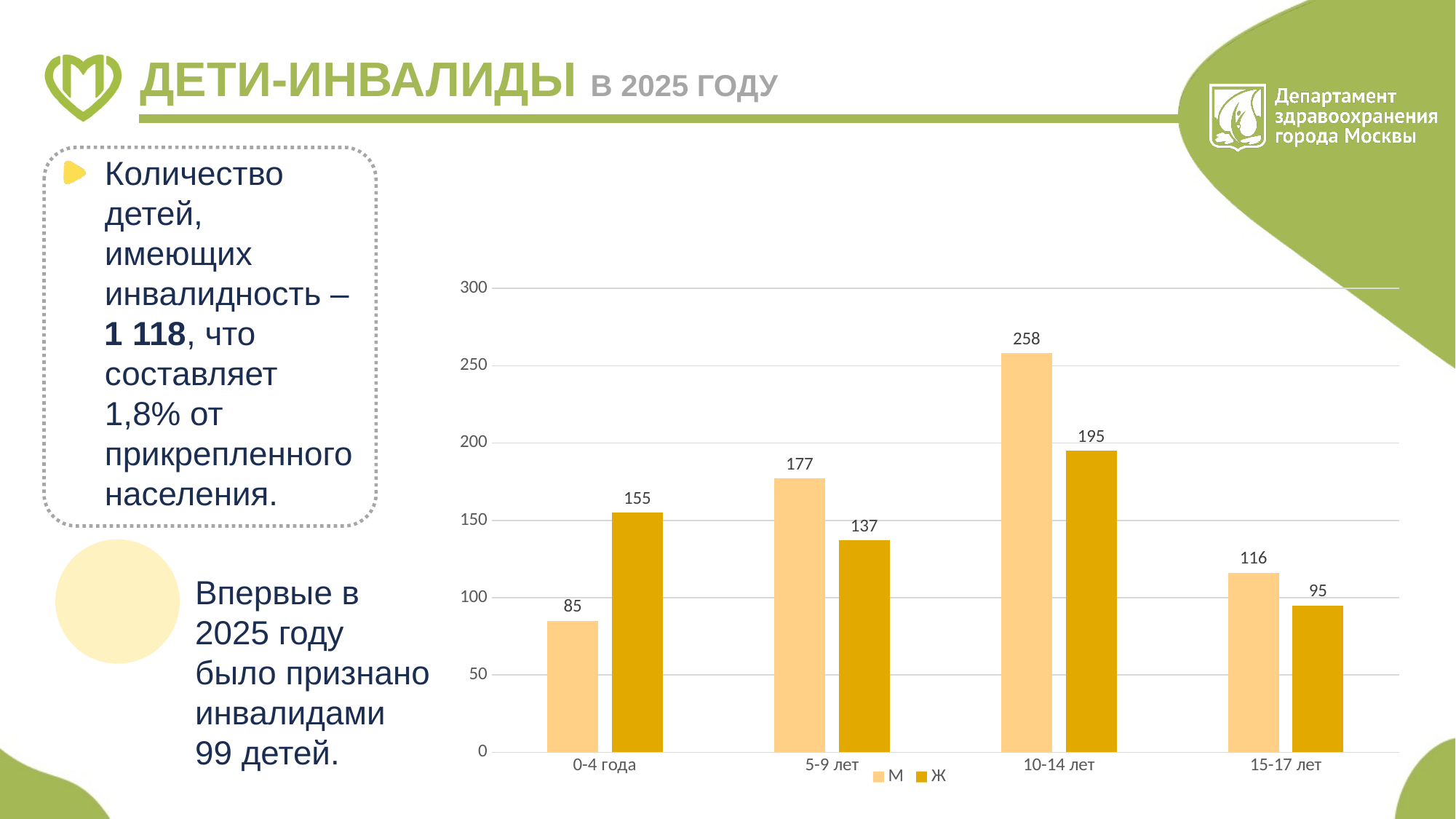
How many series does the legend list? 2 What is the difference between М and Ж in the 10-14 лет category? 63 How many age categories are shown on the x axis? 4 What kind of chart is shown on the slide? bar chart In the 0-4 года category, which is larger, М or Ж? Ж Which age category has the lowest value for М? 0-4 года What is the value for М in the 15-17 лет category? 116 What is the value for М in the 10-14 лет category? 258 Is the value for Ж in the 5-9 лет category greater or less than 150? less Which age category has the highest value for Ж? 10-14 лет What are the two series named in the legend? М and Ж What is the value for Ж in the 0-4 года category? 155